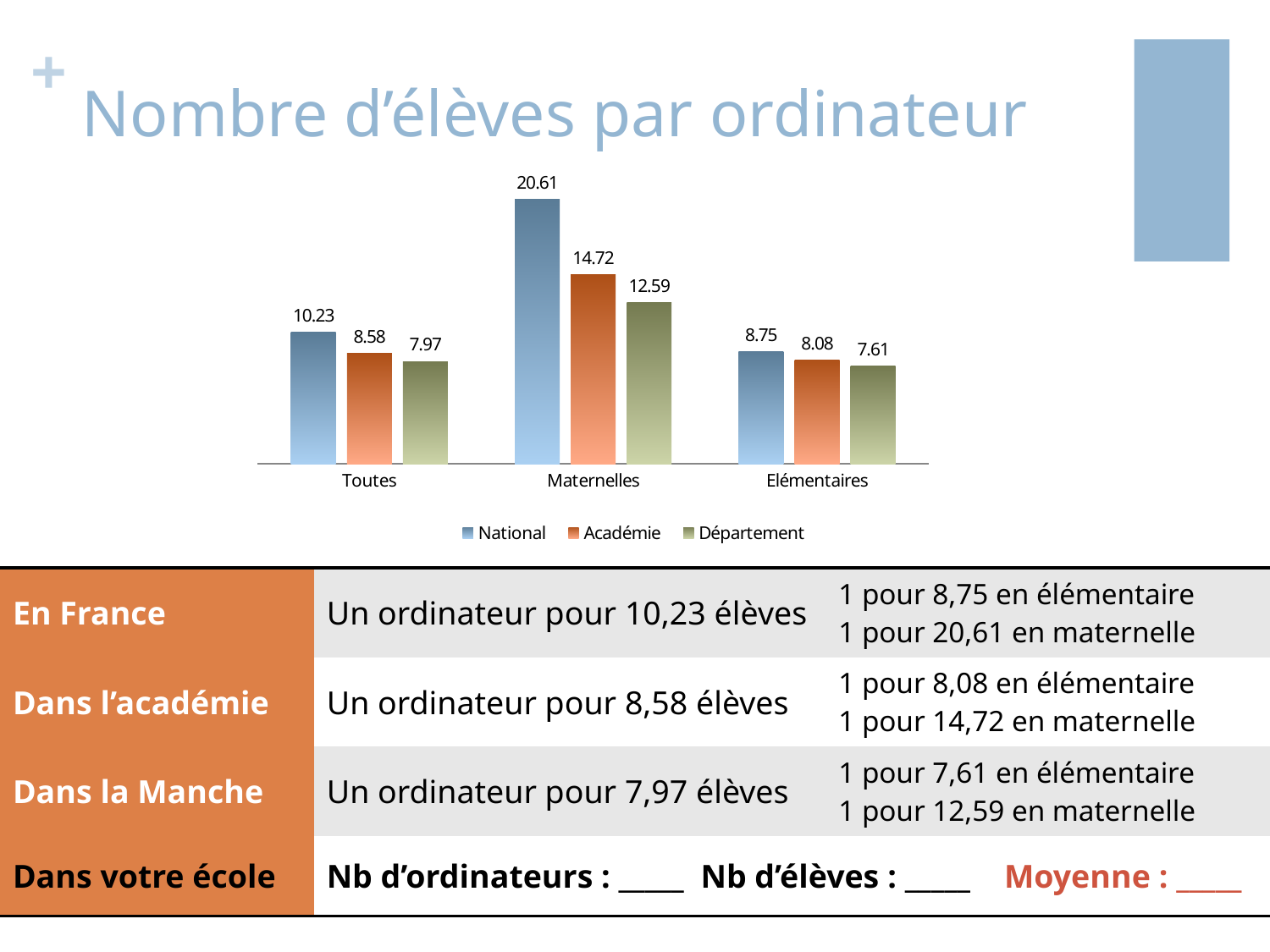
Which is larger for Toutes: the National value or the Académie value? National Which series is shown in orange in the legend? Académie What is the title of the slide? Nombre d'élèves par ordinateur Which category has the highest National value? Maternelles Which series has the lowest value for Elémentaires? Département How many categories are shown on the x axis? 3 What is the Académie value for Elémentaires? 8.08 What is the difference between the National and Académie values for Maternelles? 5.89 What kind of chart is shown on the slide? Bar chart How many series does the legend list? 3 What is the National value for Maternelles? 20.61 What is the Département value for Toutes? 7.97